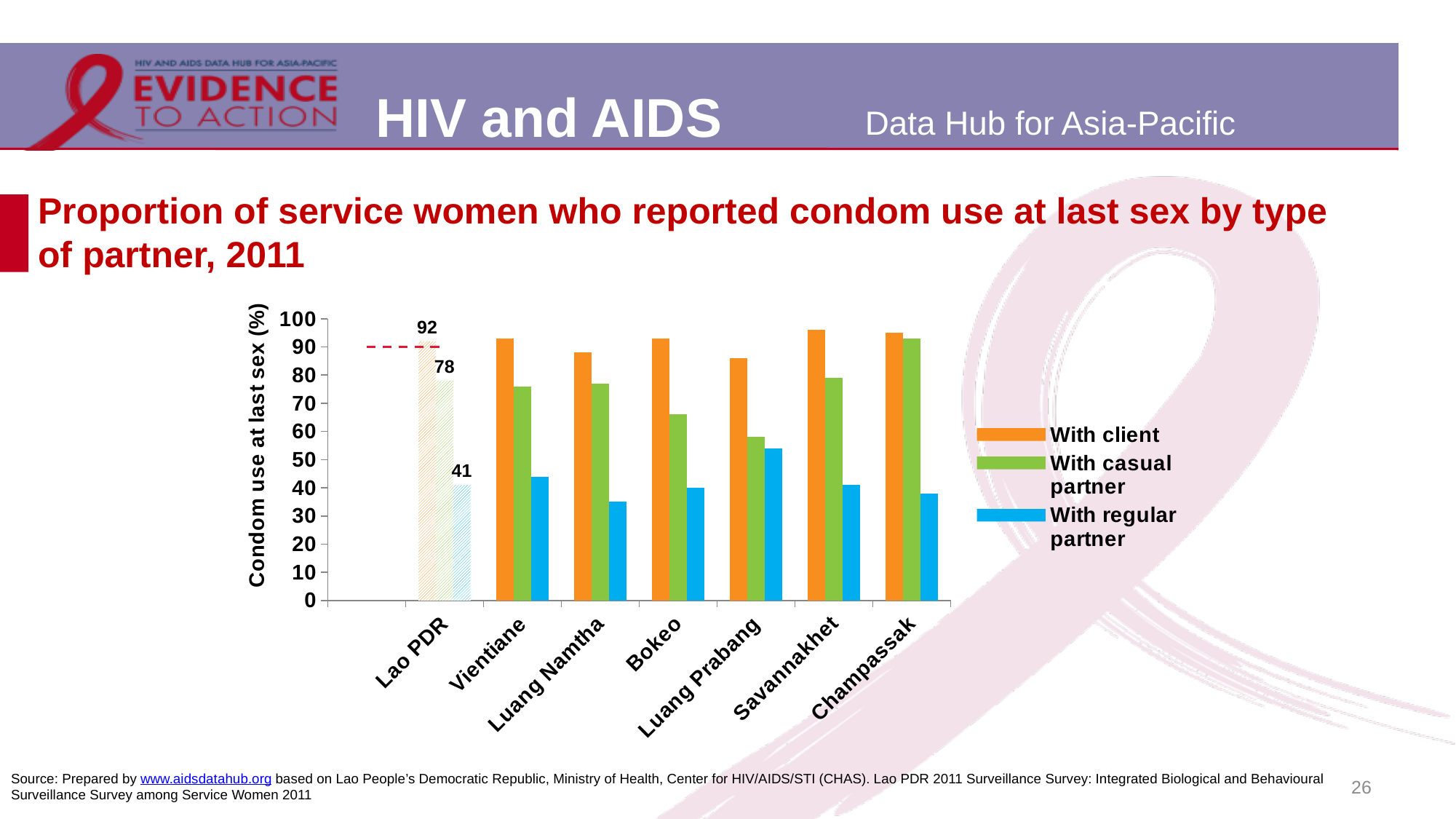
How many series does the legend list? 3 What is the value for Lao PDR in the 'With regular partner' series? 41 For Lao PDR, what is the difference between the 'With client' value and the 'With casual partner' value? 14 What kind of chart is shown on the slide? Bar chart How many categories are shown on the x axis of the chart? 7 For Lao PDR, what is the difference between the 'With client' value and the 'With regular partner' value? 51 Which category has the highest 'With casual partner' value? Champassak Is the 'With casual partner' value for Luang Prabang greater or less than 50? greater What is the value for Lao PDR in the 'With client' series? 92 Is the 'With regular partner' value for Luang Namtha greater or less than 40? less Which has the larger 'With casual partner' value, Champassak or Bokeo? Champassak What is the value for Lao PDR in the 'With casual partner' series? 78